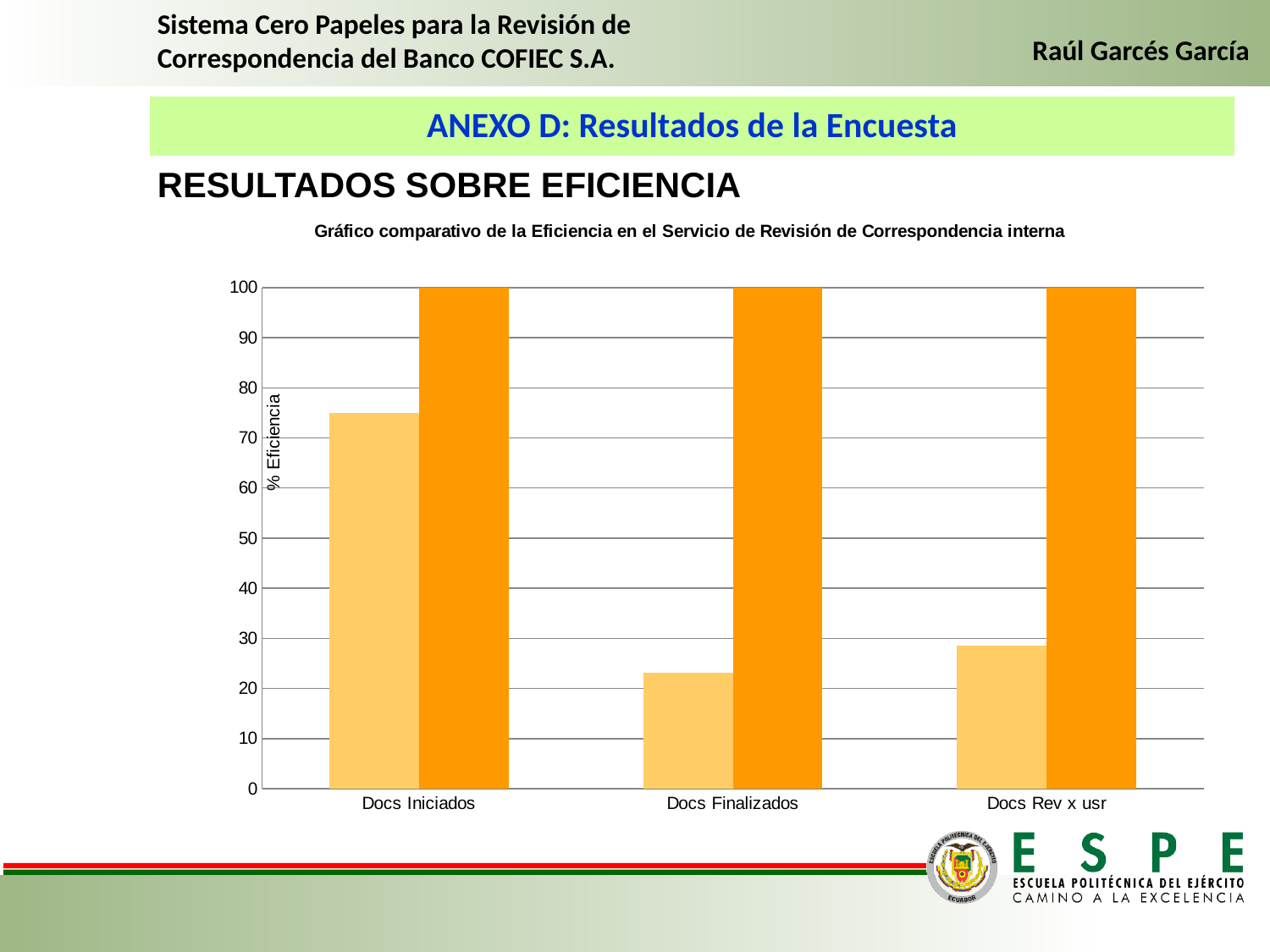
Is the value of the light orange bar for Docs Finalizados greater or less than 30? less Which category has the highest light orange bar? Docs Iniciados What is the value of the dark orange bar for Docs Finalizados? 100 Is the value of the light orange bar for Docs Rev x usr greater or less than 20? greater What is the value of the dark orange bar for Docs Rev x usr? 100 What is the value of the dark orange bar for Docs Iniciados? 100 Which light orange bar is larger, Docs Iniciados or Docs Finalizados? Docs Iniciados What is the label on the vertical axis of the chart? % Eficiencia How many categories are shown on the x axis of the chart? 3 What is the title of the chart? Gráfico comparativo de la Eficiencia en el Servicio de Revisión de Correspondencia interna Is the value of the light orange bar for Docs Iniciados greater or less than 70? greater What kind of chart is shown on the slide? bar chart